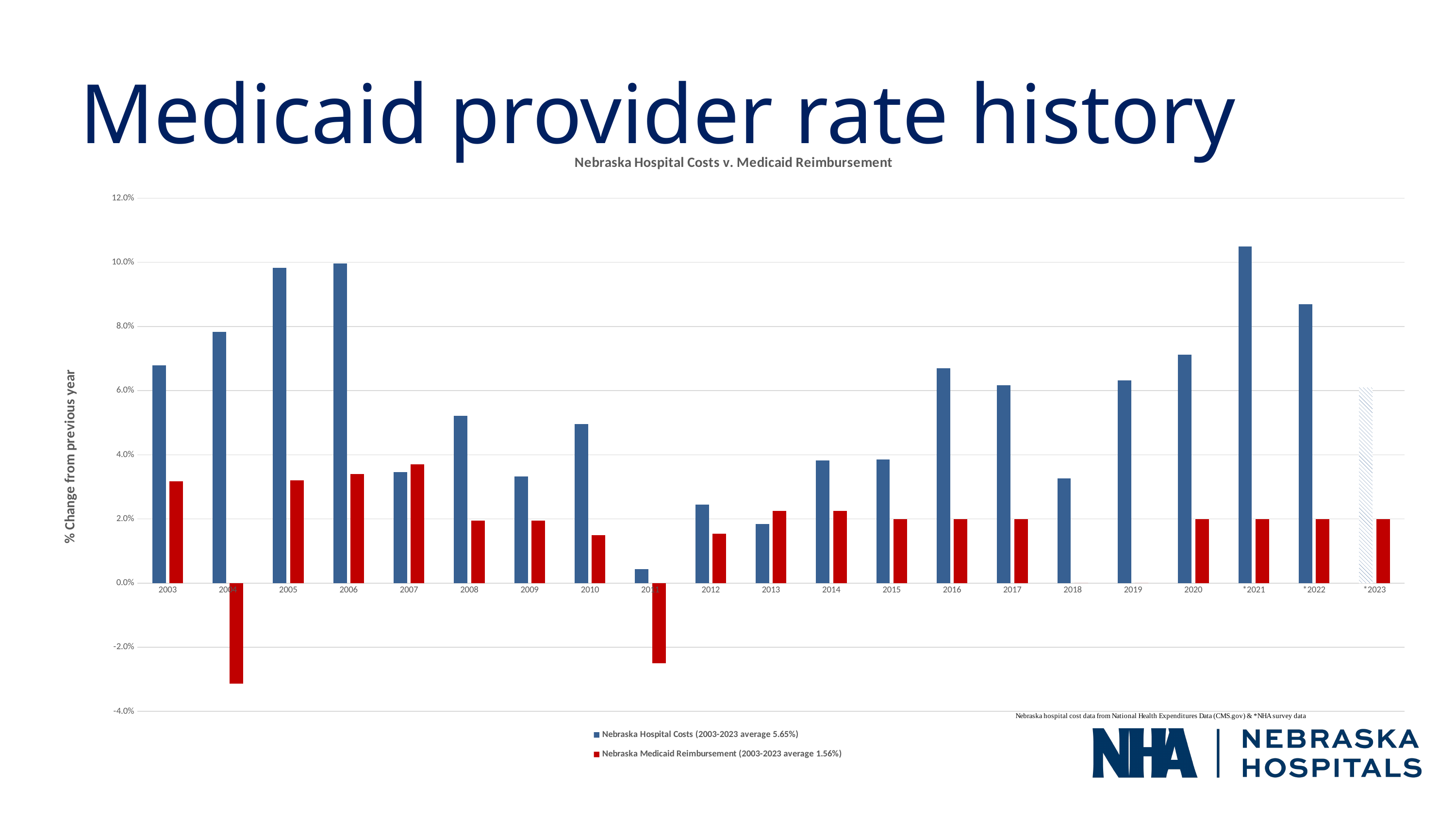
In 2016, which is larger: Nebraska Hospital Costs or Nebraska Medicaid Reimbursement? Nebraska Hospital Costs How many series does the legend list? 2 What kind of chart is shown on the slide? Bar chart In which year is the Nebraska Hospital Costs value lowest? 2011 Is the Nebraska Hospital Costs value for 2005 greater or less than 8.0%? greater Is the Nebraska Medicaid Reimbursement value for 2011 greater or less than 0.0%? less In 2013, which is larger: Nebraska Hospital Costs or Nebraska Medicaid Reimbursement? Nebraska Medicaid Reimbursement How many years are shown on the x axis? 21 According to the legend, what is the 2003-2023 average for Nebraska Medicaid Reimbursement? 1.56% In which year is the Nebraska Medicaid Reimbursement value lowest? 2004 In which year is the Nebraska Hospital Costs value highest? *2021 Is the Nebraska Hospital Costs value for 2018 greater or less than 4.0%? less